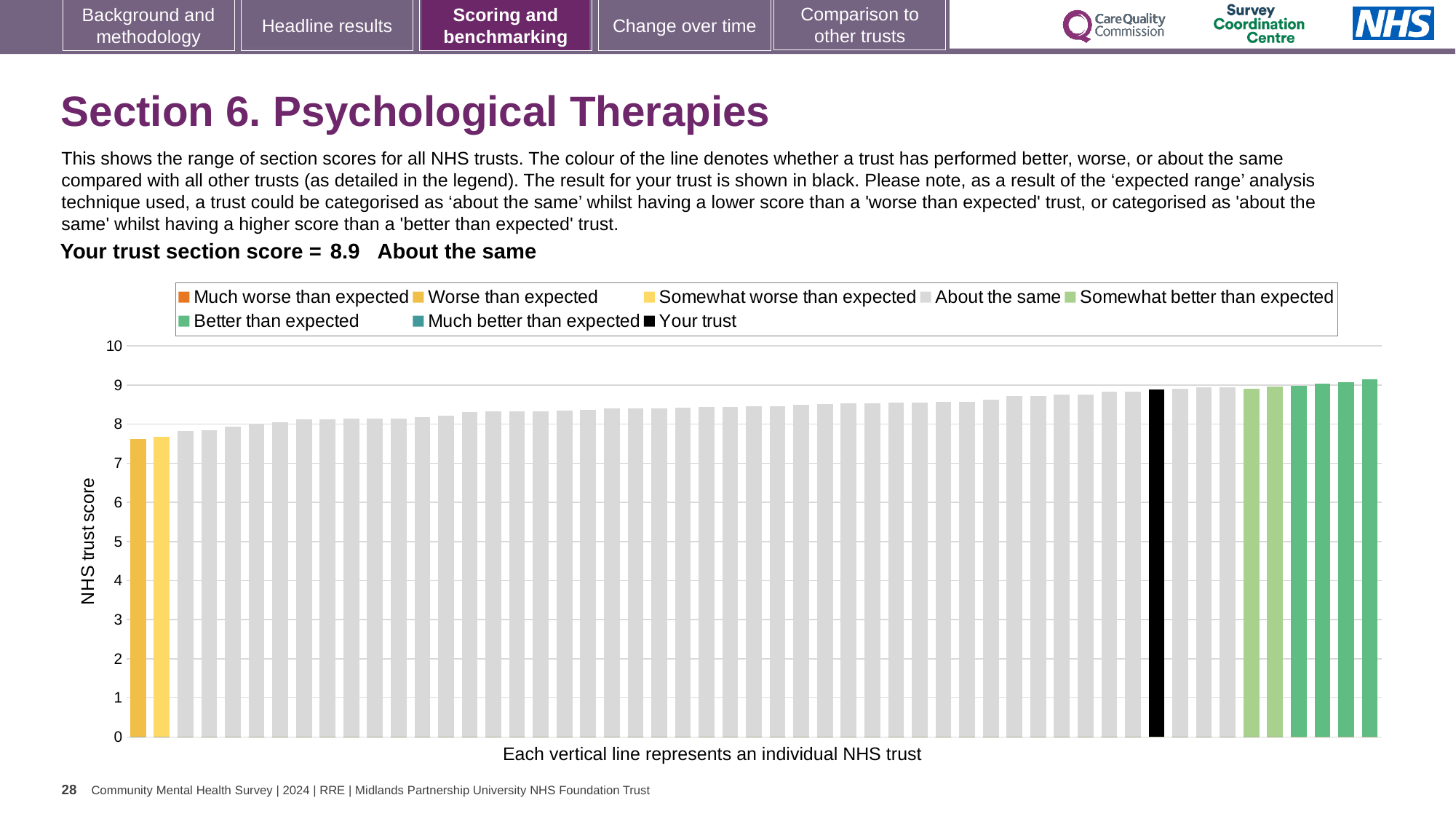
Is the value of the rightmost bar greater or less than 10? less How many entries does the chart legend list? 8 Is the value of the leftmost bar greater or less than 8? less Which category is your trust's section score placed in? About the same Is the value of the black bar (your trust) greater or less than 8? greater Do the bar values rise or fall from left to right along the x axis? rise What is the label on the vertical axis of the chart? NHS trust score What is the section score for your trust shown on the slide? 8.9 According to the legend, what colour represents your trust? black What kind of chart is shown on the slide? bar chart Which is higher, the black bar for your trust or the leftmost bar? the black bar for your trust